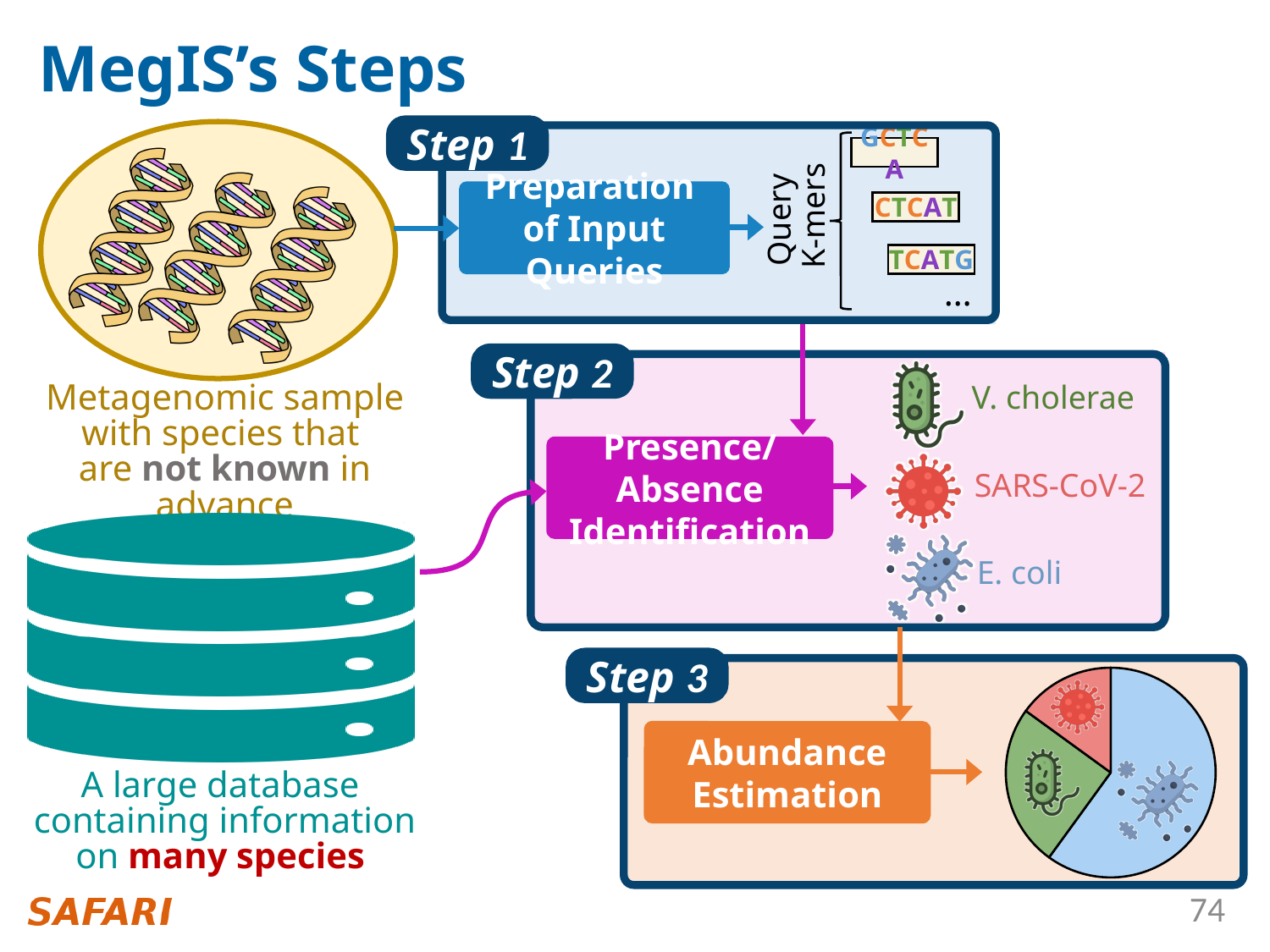
Which step's box on the slide contains the pie chart? Step 3 In the pie chart in the Step 3 box, is the blue slice or the green slice larger? blue In the pie chart in the Step 3 box, which coloured slice is the largest? blue How many slices does the pie chart in the Step 3 box have? 3 What kind of chart is shown in the Step 3 box of the slide? pie chart What is the label of the orange box that points to the pie chart in Step 3? Abundance Estimation In the pie chart in the Step 3 box, is the blue slice or the red slice larger? blue